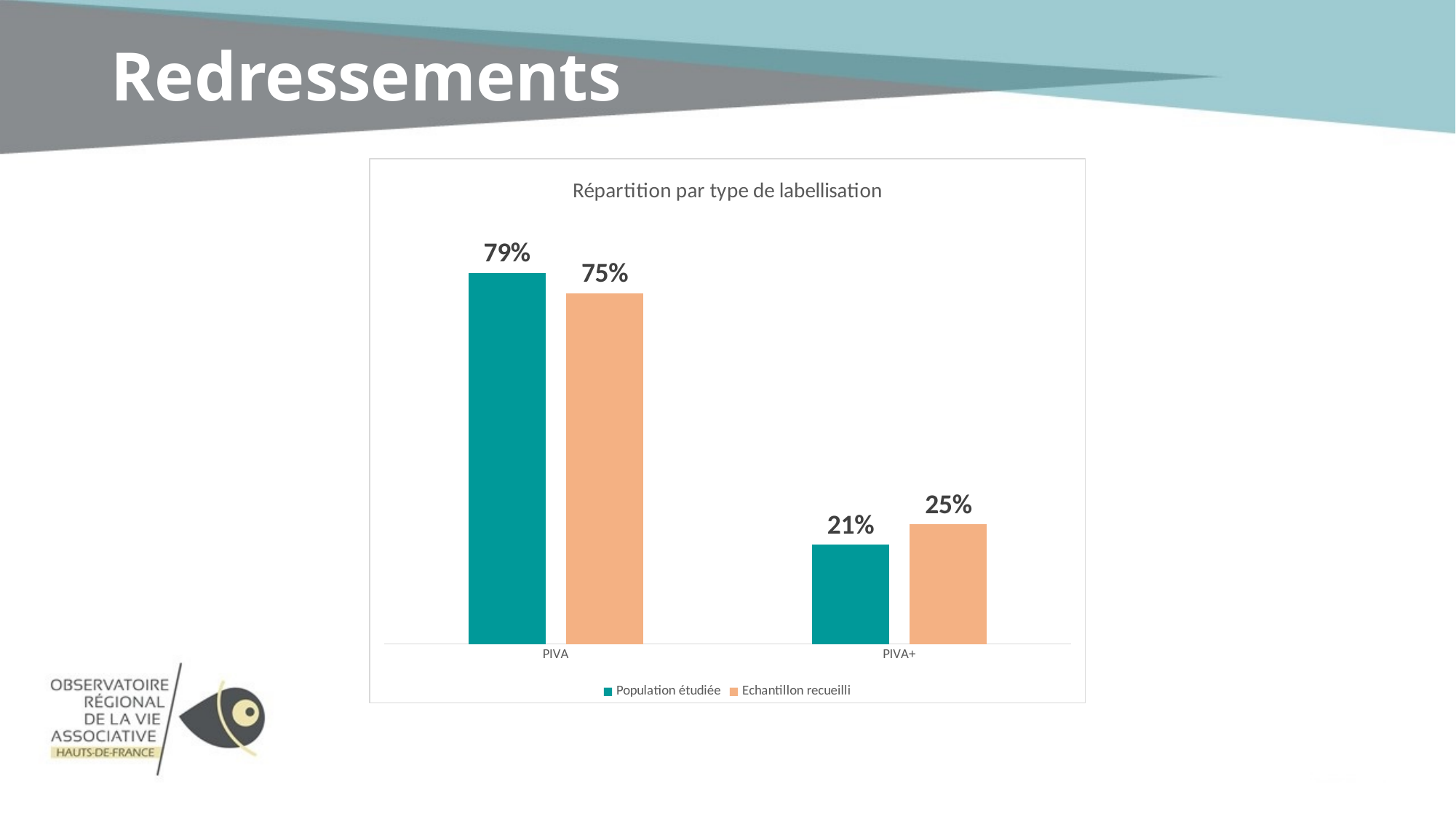
Which category has the lowest value for Echantillon recueilli? PIVA+ What is the value for Echantillon recueilli in the PIVA category? 75% What is the value for Population étudiée in the PIVA category? 79% What is the value for Echantillon recueilli in the PIVA+ category? 25% How many categories are shown on the x axis? 2 What is the difference between Echantillon recueilli and Population étudiée for PIVA+? 4% How many series does the legend list? 2 Which category has the highest value for Population étudiée? PIVA What is the difference between Population étudiée and Echantillon recueilli for PIVA? 4% What is the value for Population étudiée in the PIVA+ category? 21% For PIVA+, which series has the larger value: Population étudiée or Echantillon recueilli? Echantillon recueilli What is the title of the chart? Répartition par type de labellisation